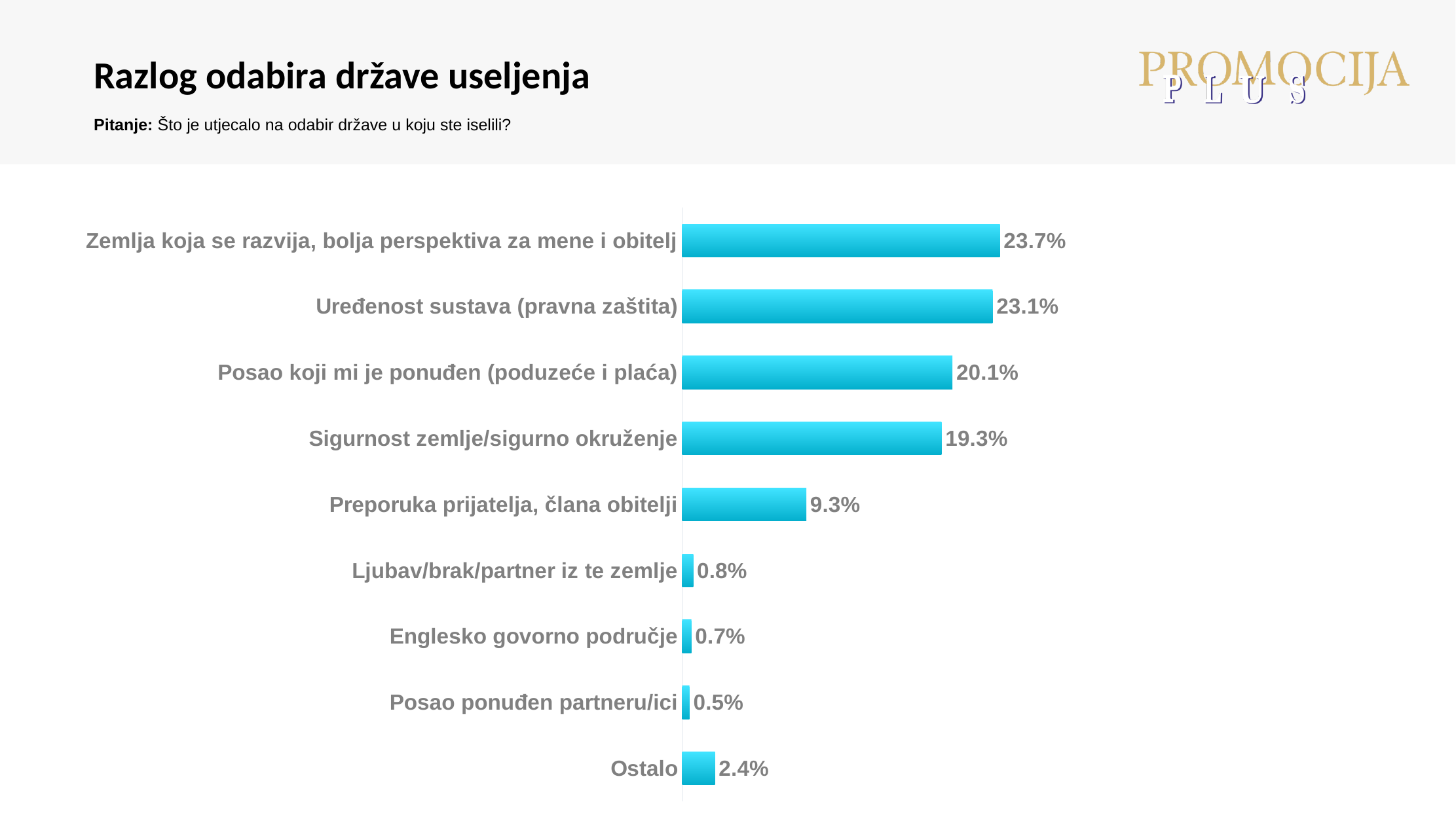
What kind of chart is shown on the slide? Bar chart What is the difference between "Preporuka prijatelja, člana obitelji" and "Ostalo"? 6.9 percentage points Which is larger: "Ostalo" or "Ljubav/brak/partner iz te zemlje"? Ostalo Which category has the lowest value? Posao ponuđen partneru/ici What is the value for "Englesko govorno područje"? 0.7% How many categories are shown in the chart? 9 Which category has the highest value? Zemlja koja se razvija, bolja perspektiva za mene i obitelj What is the value for "Ostalo"? 2.4% What is the difference between "Zemlja koja se razvija, bolja perspektiva za mene i obitelj" and "Uređenost sustava (pravna zaštita)"? 0.6 percentage points What is the title of the slide? Razlog odabira države useljenja What is the value for "Zemlja koja se razvija, bolja perspektiva za mene i obitelj"? 23.7% What is the value for "Sigurnost zemlje/sigurno okruženje"? 19.3%